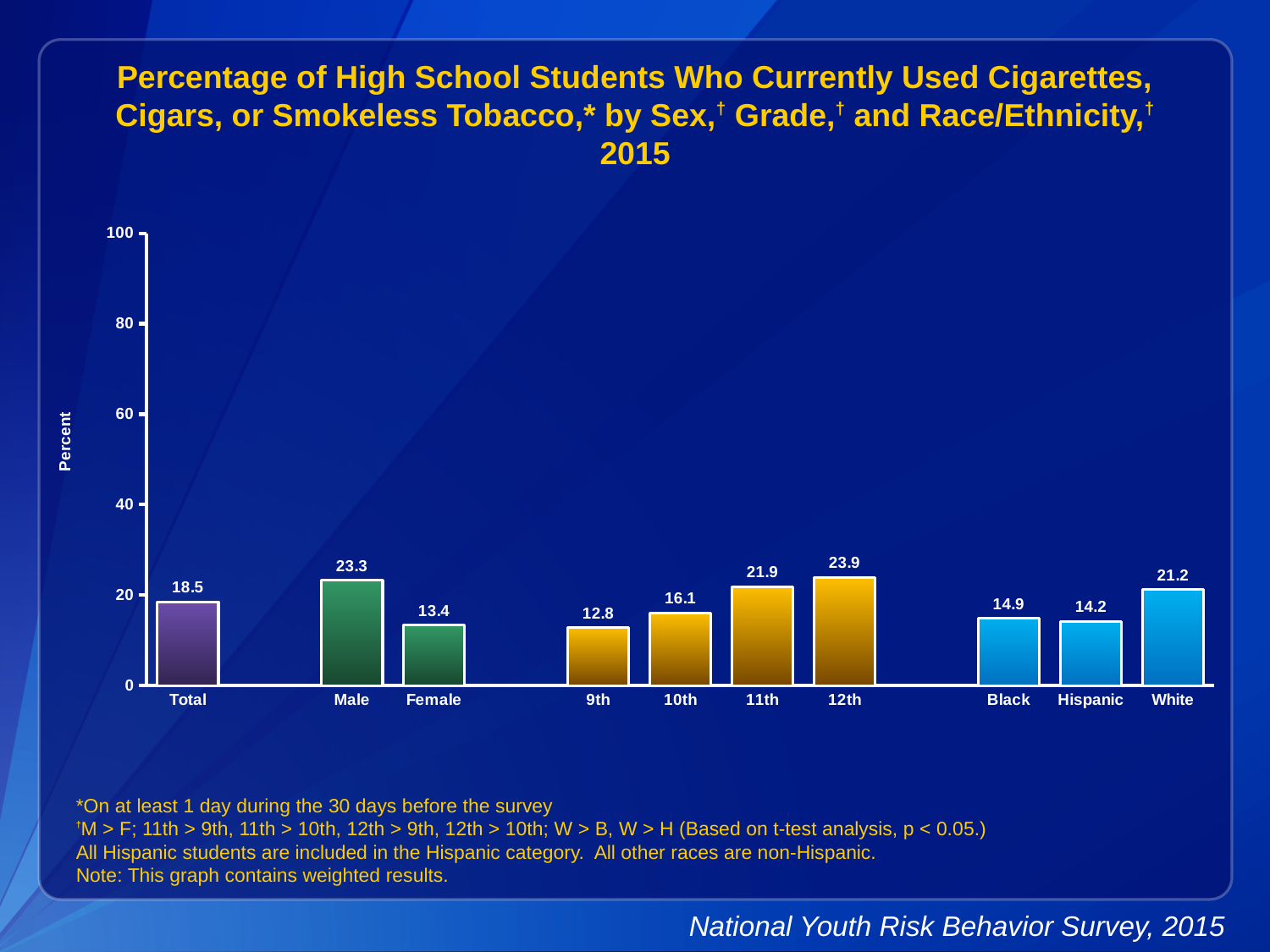
Do the values rise or fall from 9th grade to 12th grade? rise What is the difference between the Male and Female values? 9.9 Which category has the lowest value? 9th What is the value for 10th grade? 16.1 Which is larger, the value for White or the value for Black? White Which category has the highest value? 12th Is the value for 11th grade greater or less than 20? greater What is the value for Female? 13.4 What is the value for Total? 18.5 What kind of chart is this? bar chart What is the value for Hispanic? 14.2 How many categories are shown on the x axis? 10